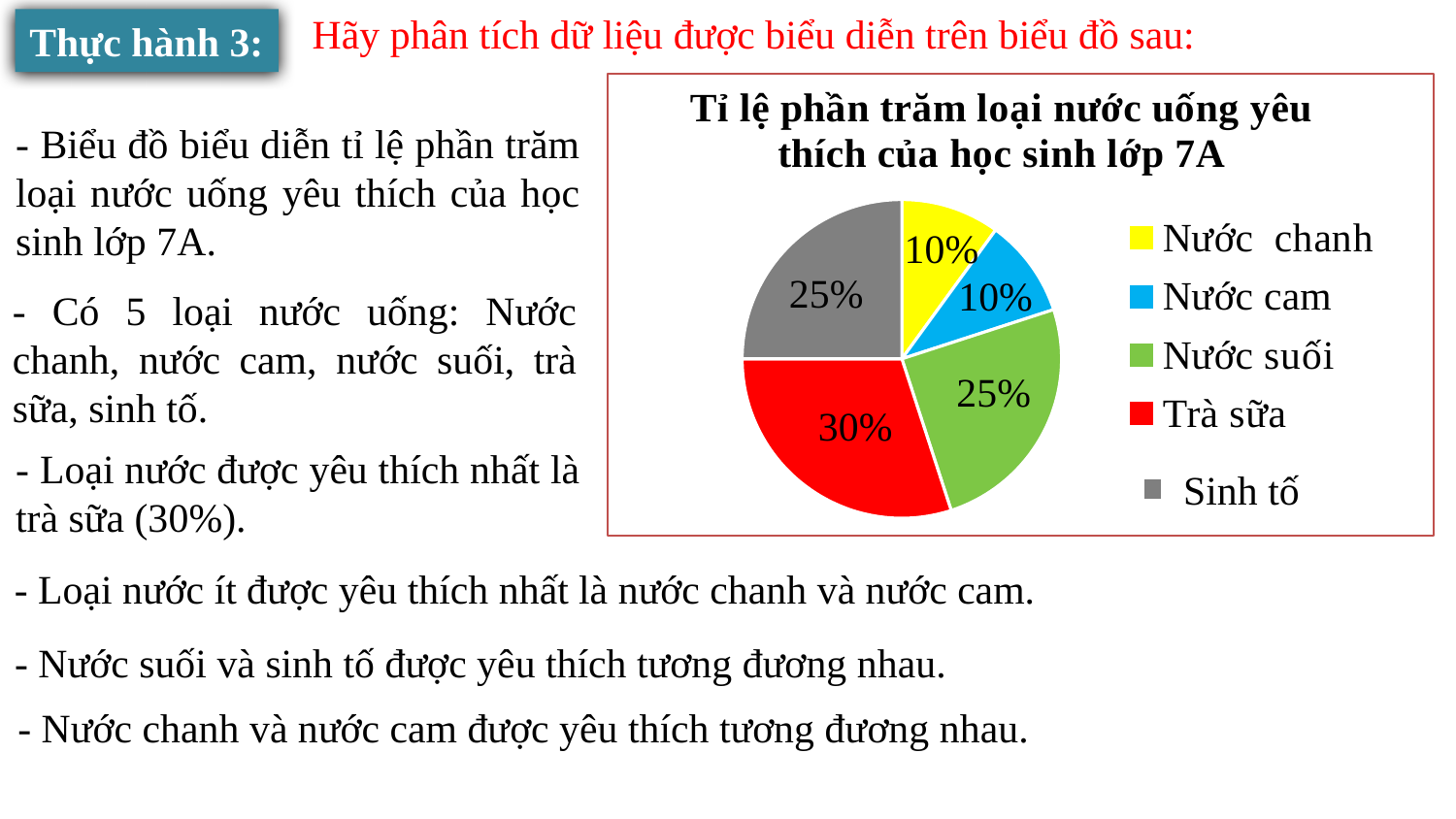
What is the title of the pie chart? Tỉ lệ phần trăm loại nước uống yêu thích của học sinh lớp 7A What percentage of the pie chart is Nước cam? 10% Which drink has the largest slice of the pie chart? Trà sữa How many entries does the legend of the pie chart list? 5 What type of chart is shown on the slide? pie chart What percentage of the pie chart is Trà sữa? 30% What colour is the Nước chanh slice in the pie chart? yellow Which is larger, the share for Trà sữa or the share for Sinh tố? Trà sữa How many slices does the pie chart have? 5 What is the difference in percentage points between Trà sữa and Nước suối? 5% What percentage of the pie chart is Nước suối? 25% What percentage of the pie chart is Sinh tố? 25%